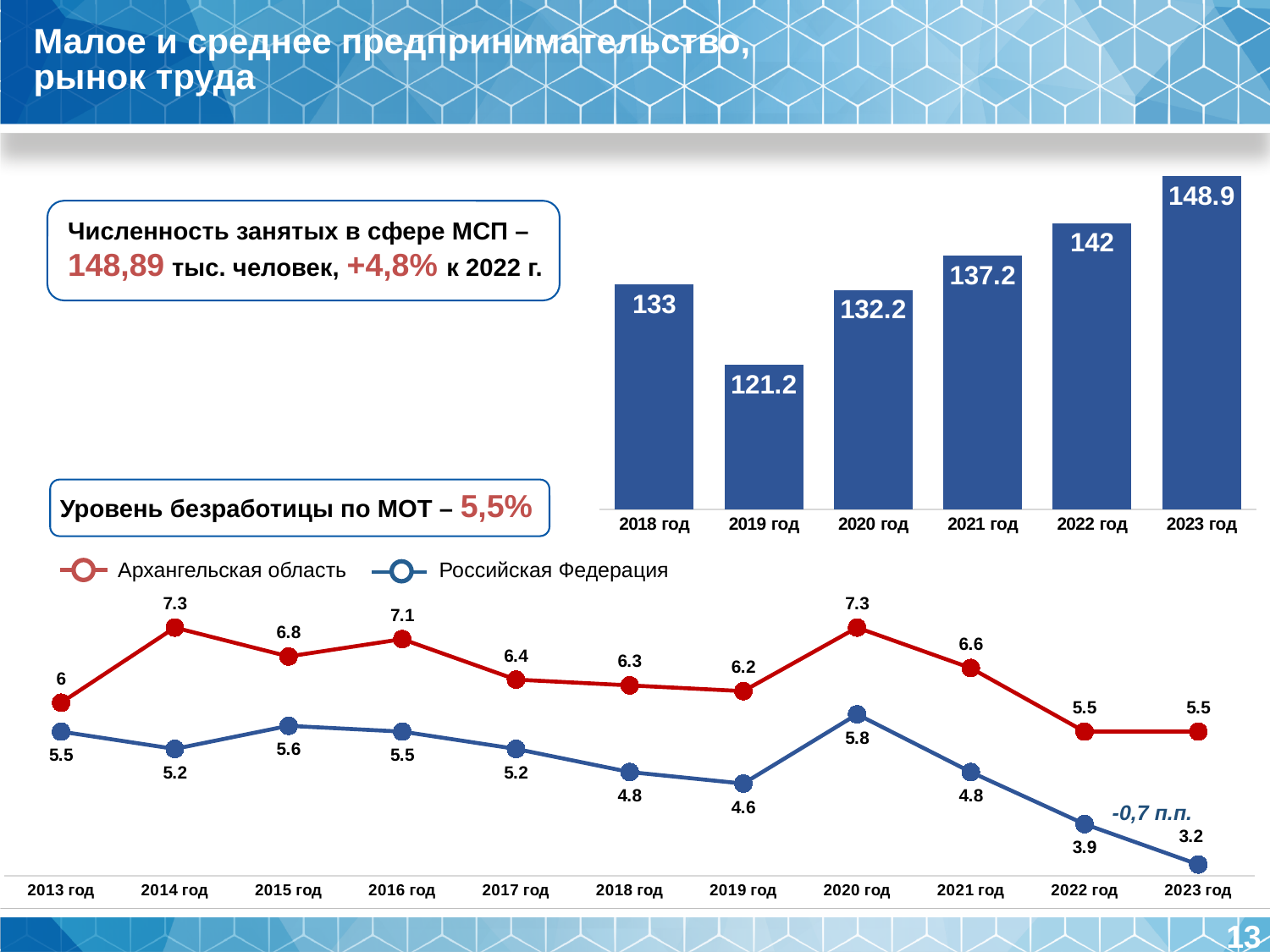
In the line chart at the bottom of the slide, how many series does the legend list? 2 In the bar chart at the top right of the slide, what is the value for 2019 год? 121.2 In the line chart at the bottom of the slide, which series has the higher value in 2020 год, Архангельская область or Российская Федерация? Архангельская область In the line chart at the bottom of the slide, does the value for Российская Федерация rise or fall from 2020 год to 2023 год? fall In the line chart at the bottom of the slide, what is the difference between Архангельская область and Российская Федерация in 2021 год? 1.8 In the bar chart at the top right of the slide, which year has the highest value? 2023 год In the line chart at the bottom of the slide, what is the value for Архангельская область in 2016 год? 7.1 What kind of chart is shown at the top right of the slide? bar chart In the bar chart at the top right of the slide, what is the difference between the values for 2023 год and 2022 год? 6.9 In the bar chart at the top right of the slide, how many bars are shown? 6 In the bar chart at the top right of the slide, which year has the lowest value? 2019 год In the line chart at the bottom of the slide, what is the value for Российская Федерация in 2023 год? 3.2